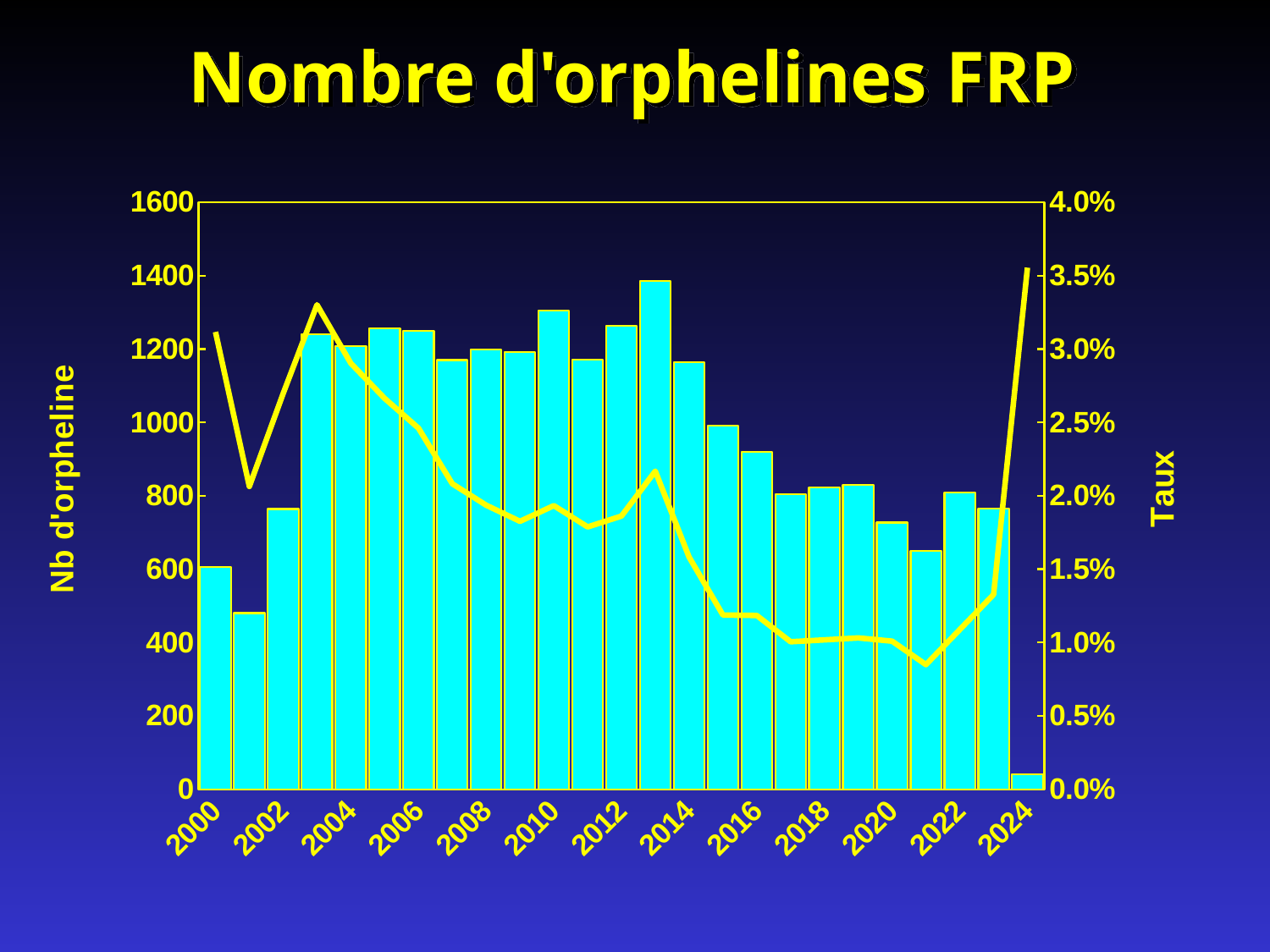
What kind of chart is shown on the slide? A combined bar and line chart How many bars (years) are plotted in the chart? 25 Which year has the tallest bar? 2013 Is the bar value for 2000 greater or less than 800? less What is the title of the chart? Nombre d'orphelines FRP Do the bar values generally rise or fall from 2013 to 2021? fall Is the rate (Taux) line value for 2024 greater or less than 3.0%? greater Is the bar value for 2013 greater or less than 1200? greater Which year has the taller bar, 2016 or 2020? 2016 What is the label of the right-hand vertical axis? Taux Which year has the shortest bar? 2024